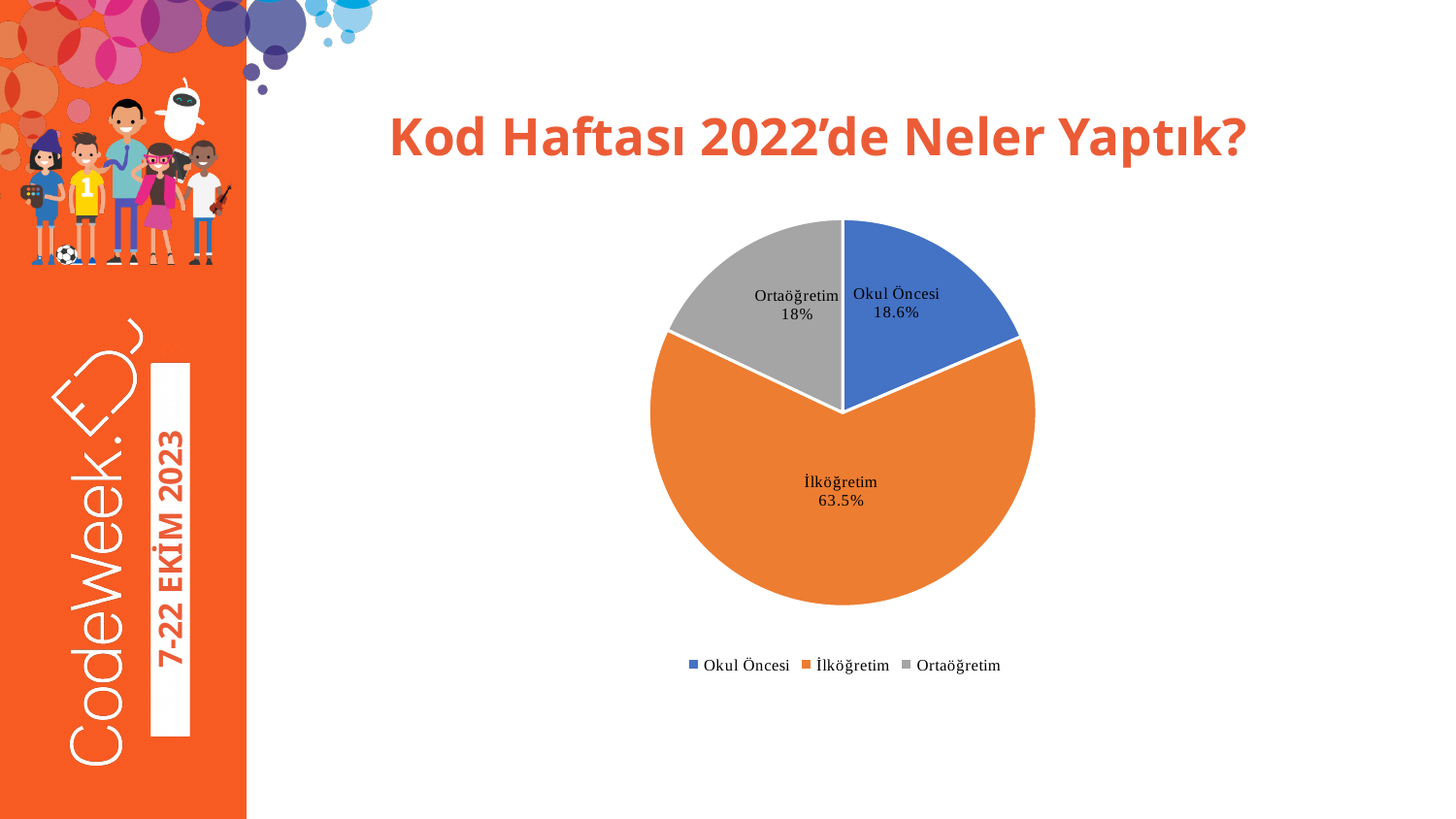
Which category has the largest slice of the pie? İlköğretim What share of the pie does Ortaöğretim have? 18% What share of the pie does Okul Öncesi have? 18.6% How many slices does the pie chart have? 3 What share of the pie does İlköğretim have? 63.5% What is the difference in percentage points between Okul Öncesi and Ortaöğretim? 0.6 Which is larger, the share for Okul Öncesi or the share for İlköğretim? İlköğretim What colour is the İlköğretim slice? orange What is the title of the slide containing the chart? Kod Haftası 2022'de Neler Yaptık? What kind of chart is shown on the slide? pie chart What is the difference in percentage points between İlköğretim and Okul Öncesi? 44.9 How many entries does the legend list? 3